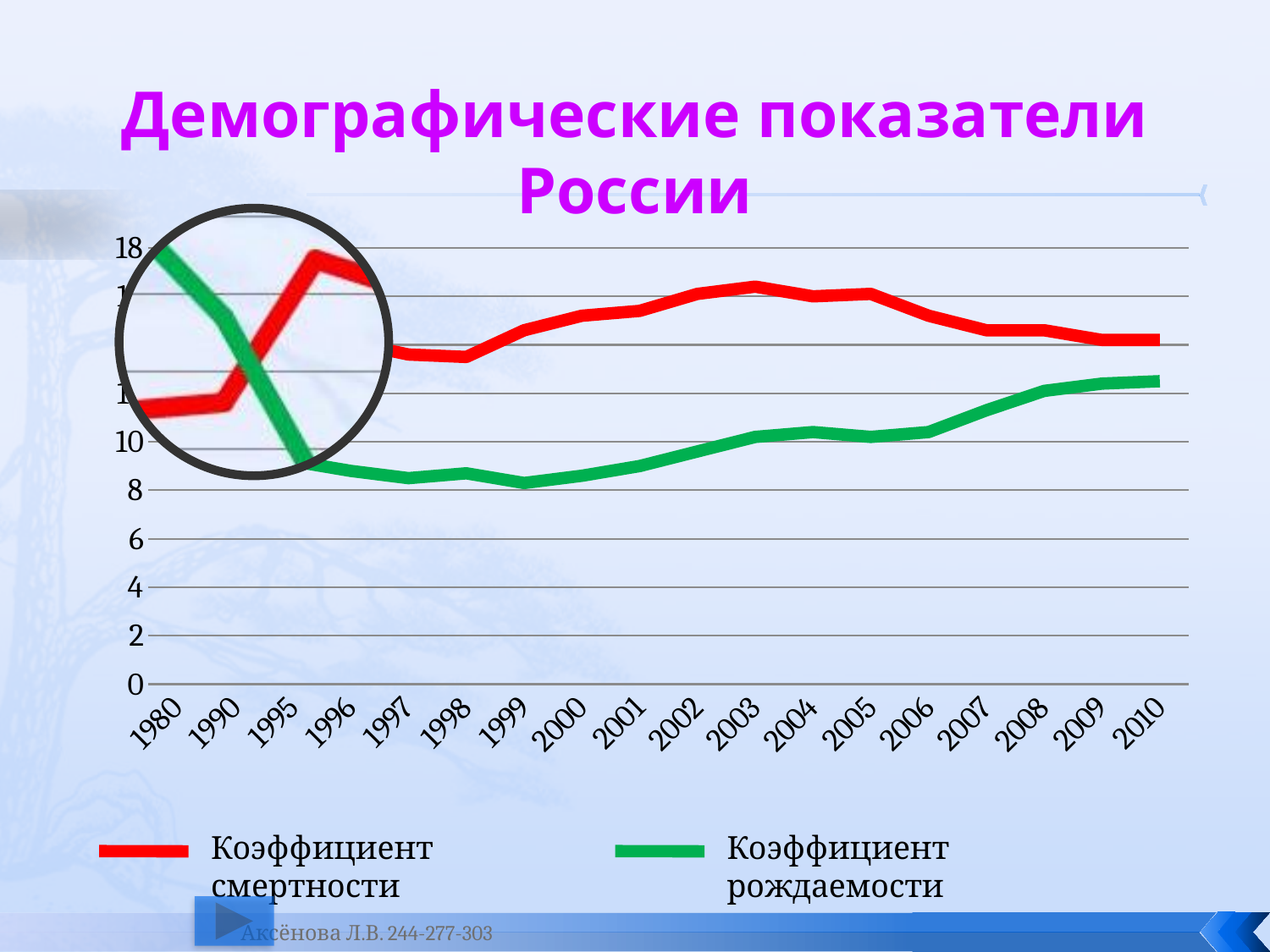
How many years are labelled on the x axis? 18 Is the value of Коэффициент рождаемости in 2010 greater or less than 10? greater In 2010, which is larger: Коэффициент смертности or Коэффициент рождаемости? Коэффициент смертности Is the value of Коэффициент смертности in 2010 greater or less than 16? less Is the value of Коэффициент рождаемости in 1999 greater or less than 10? less How many series does the legend list? 2 What kind of chart is shown on the slide? line chart Which colour represents Коэффициент рождаемости in the legend? green Does Коэффициент рождаемости rise or fall from 1999 to 2010? rise Does Коэффициент смертности rise or fall from 2003 to 2010? fall What is the title of the slide's chart? Демографические показатели России